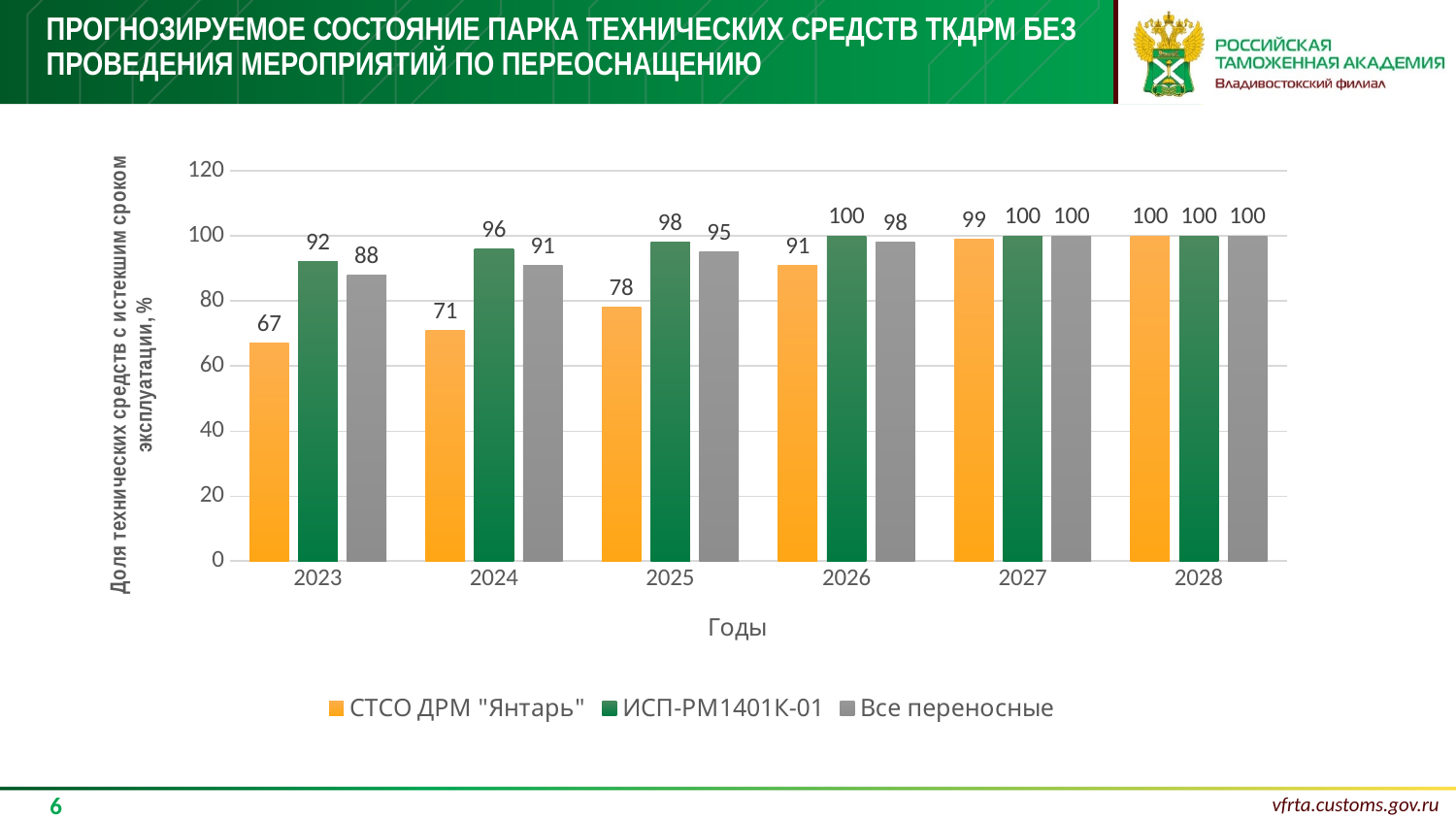
In which year is the value for СТСО ДРМ "Янтарь" lowest? 2023 What is the value for ИСП-РМ1401К-01 in 2024? 96 Which is larger in 2026: the value for СТСО ДРМ "Янтарь" or the value for Все переносные? Все переносные What is the value for Все переносные in 2025? 95 What is the value for СТСО ДРМ "Янтарь" in 2027? 99 How many years are shown on the x axis? 6 Do the values for СТСО ДРМ "Янтарь" rise or fall from 2023 to 2028? rise Is the value for СТСО ДРМ "Янтарь" in 2024 greater or less than 80? less What is the difference between the ИСП-РМ1401К-01 value and the СТСО ДРМ "Янтарь" value in 2023? 25 What is the value for СТСО ДРМ "Янтарь" in 2023? 67 What kind of chart is shown on the slide? bar chart How many series does the legend list? 3